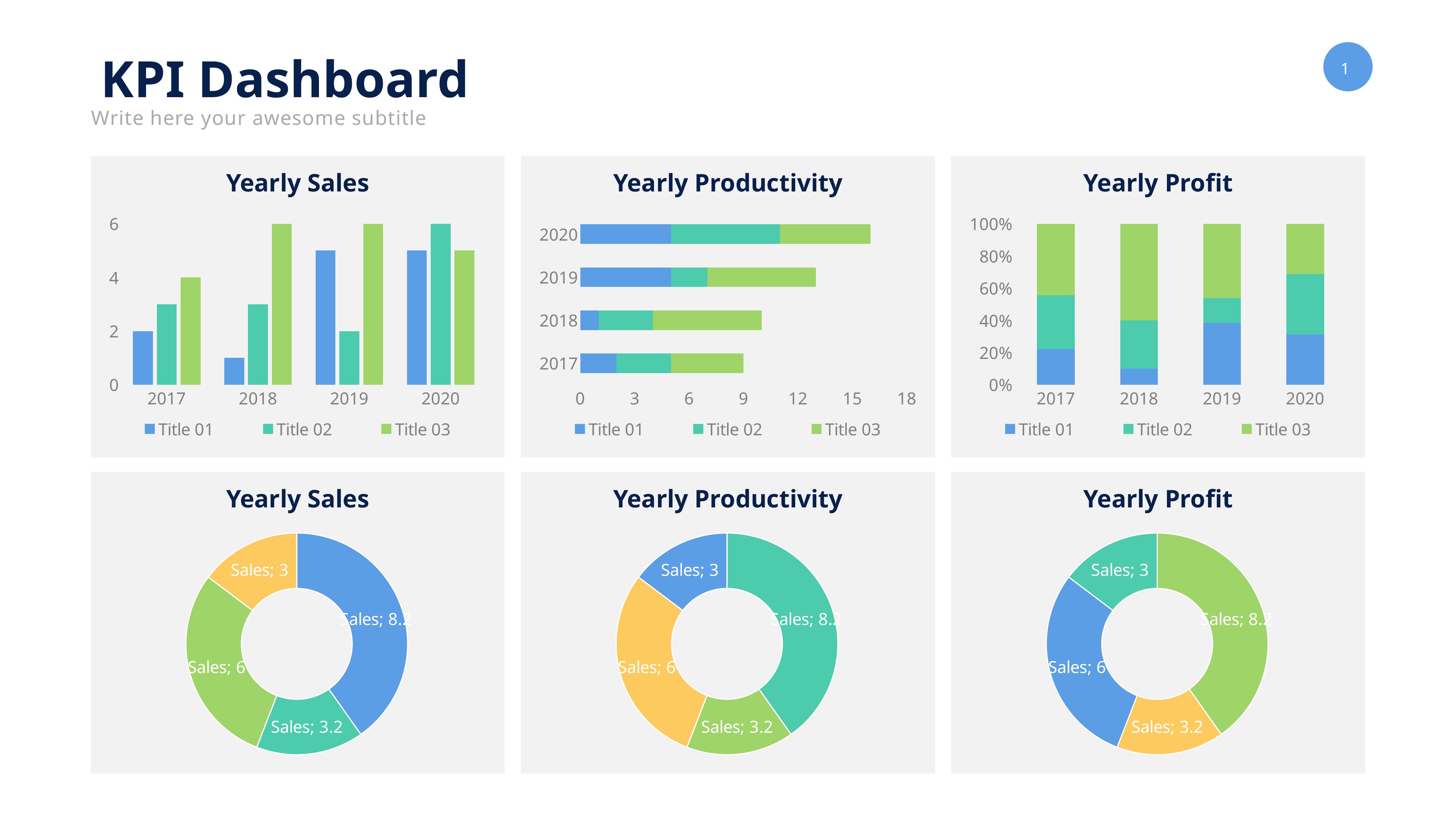
In the top-left Yearly Sales bar chart, which series has the lowest value in 2018? Title 01 In the top-right Yearly Profit chart, how many series does the legend list? 3 What kind of chart is the top-middle Yearly Productivity chart? Stacked horizontal bar chart In the bottom-left Yearly Sales donut chart, which slice has the largest value? Sales; 8.2 In the top-left Yearly Sales bar chart, what is the value of Title 03 in 2018? 6 In the top-middle Yearly Productivity chart, which year has the longest bar? 2020 In the top-right Yearly Profit chart, is the Title 01 share for 2018 greater or less than 20%? less In the top-left Yearly Sales bar chart, how many years are shown on the x axis? 4 In the top-middle Yearly Productivity chart, what is the total length of the 2017 bar? 9 In the top-left Yearly Sales bar chart, what is the value of Title 01 in 2017? 2 In the top-middle Yearly Productivity chart, is the total for 2020 greater or less than 15? greater In the top-left Yearly Sales bar chart, is the value of Title 01 in 2019 greater or less than 4? greater